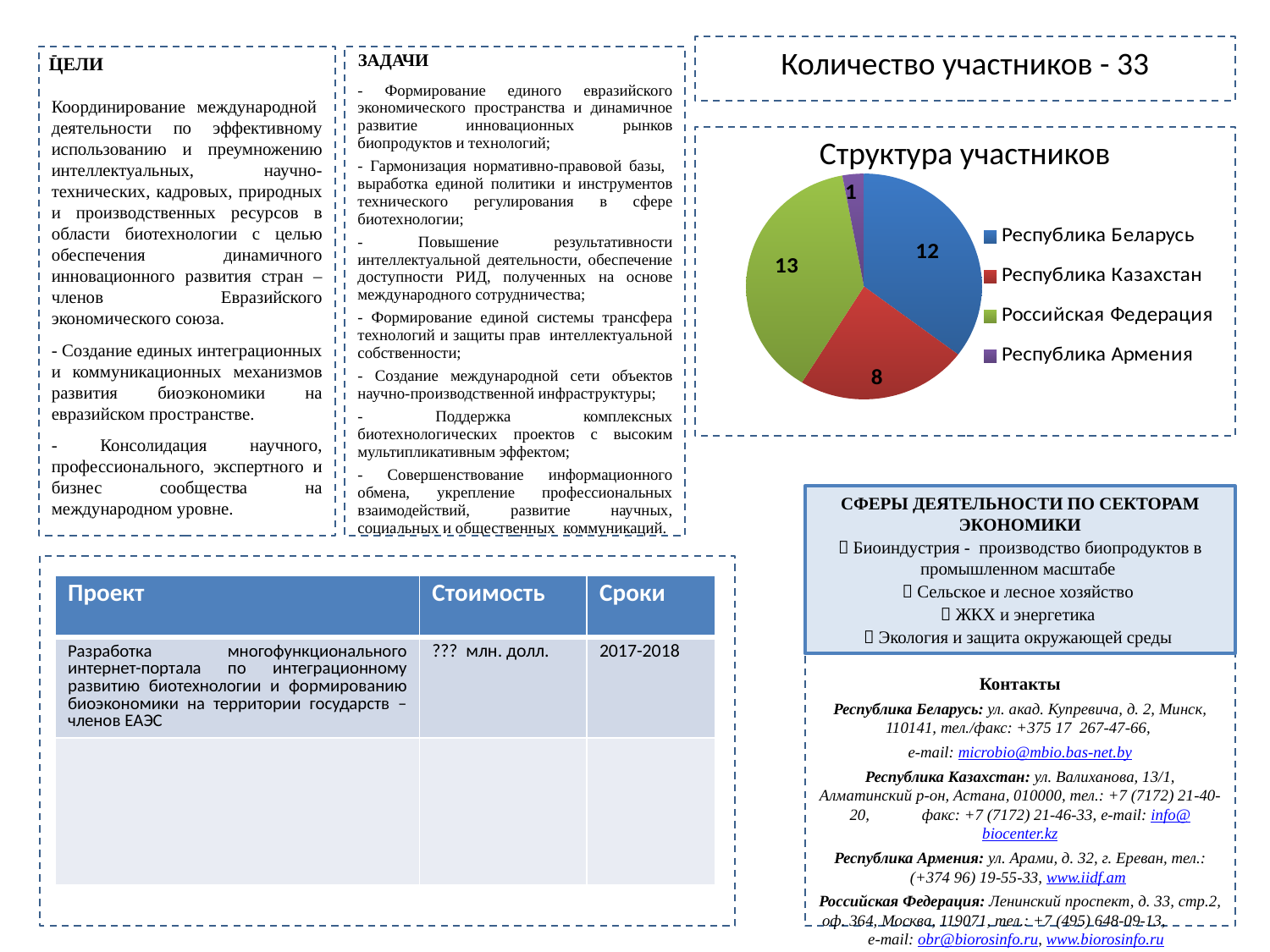
What kind of chart is shown under the title "Структура участников"? pie chart In the pie chart "Структура участников", which category has the smallest value? Республика Армения In the pie chart "Структура участников", what is the value for Республика Казахстан? 8 In the pie chart "Структура участников", what is the value for Республика Беларусь? 12 In the pie chart "Структура участников", which category has the largest value? Российская Федерация In the pie chart "Структура участников", what is the value for Республика Армения? 1 In the pie chart "Структура участников", what colour is the slice for Российская Федерация? green What is the title of the pie chart on the slide? Структура участников In the pie chart "Структура участников", what is the value for Российская Федерация? 13 In the pie chart "Структура участников", which is larger: the value for Республика Беларусь or the value for Республика Казахстан? Республика Беларусь In the pie chart "Структура участников", what is the difference between the values for Республика Беларусь and Республика Казахстан? 4 How many categories does the pie chart "Структура участников" show? 4